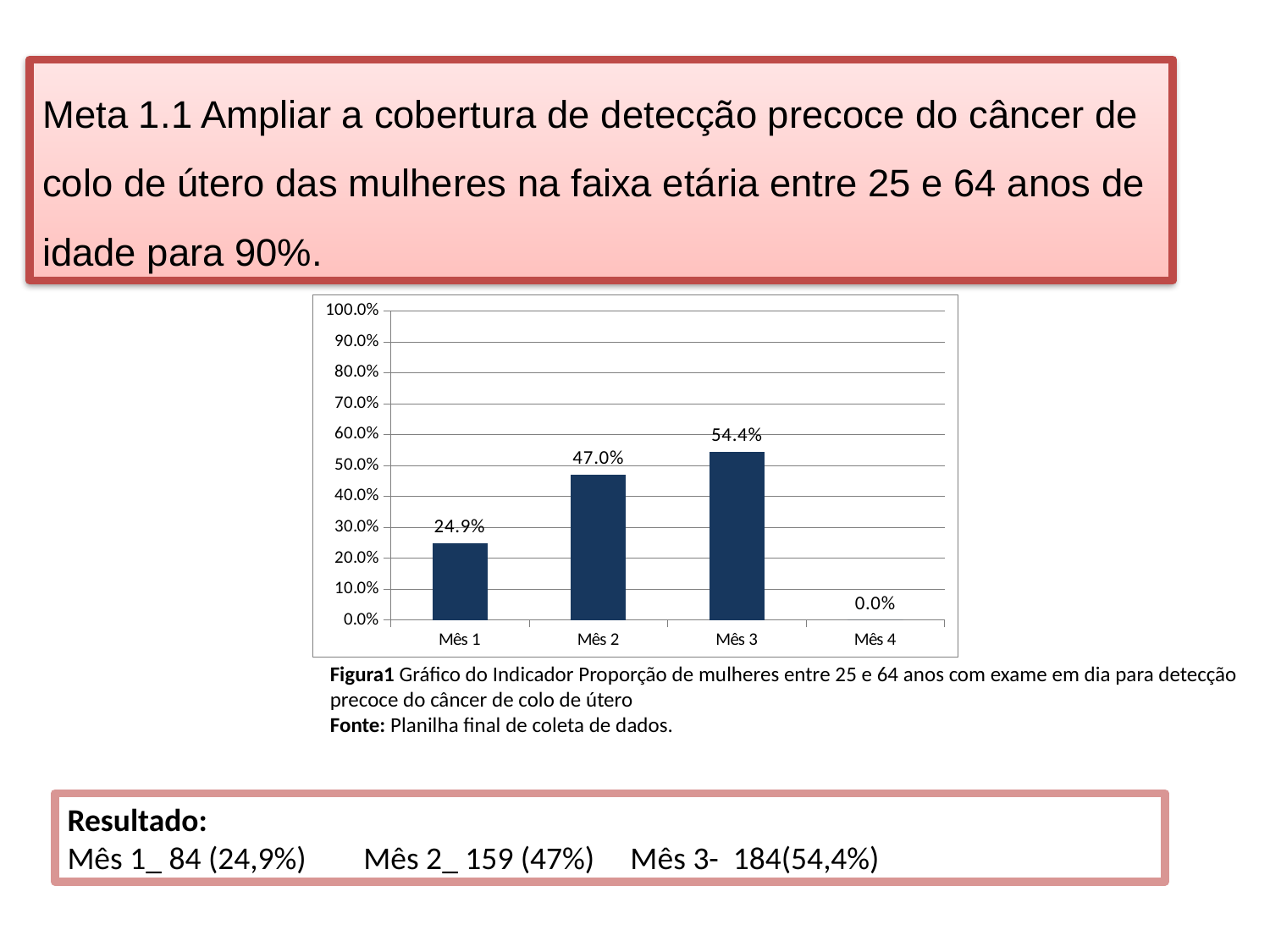
What is the value for Mês 3? 54.4% What is the difference between the values for Mês 2 and Mês 1? 22.1% What is the difference between the values for Mês 3 and Mês 2? 7.4% Which category has the highest value? Mês 3 Which category has the lowest value? Mês 4 Which is larger, the value for Mês 1 or the value for Mês 2? Mês 2 What is the value for Mês 2? 47.0% What kind of chart is shown on the slide? bar chart What is the value for Mês 1? 24.9% How many categories are shown on the x axis? 4 What is the value for Mês 4? 0.0% Do the values rise or fall from Mês 1 to Mês 3? rise